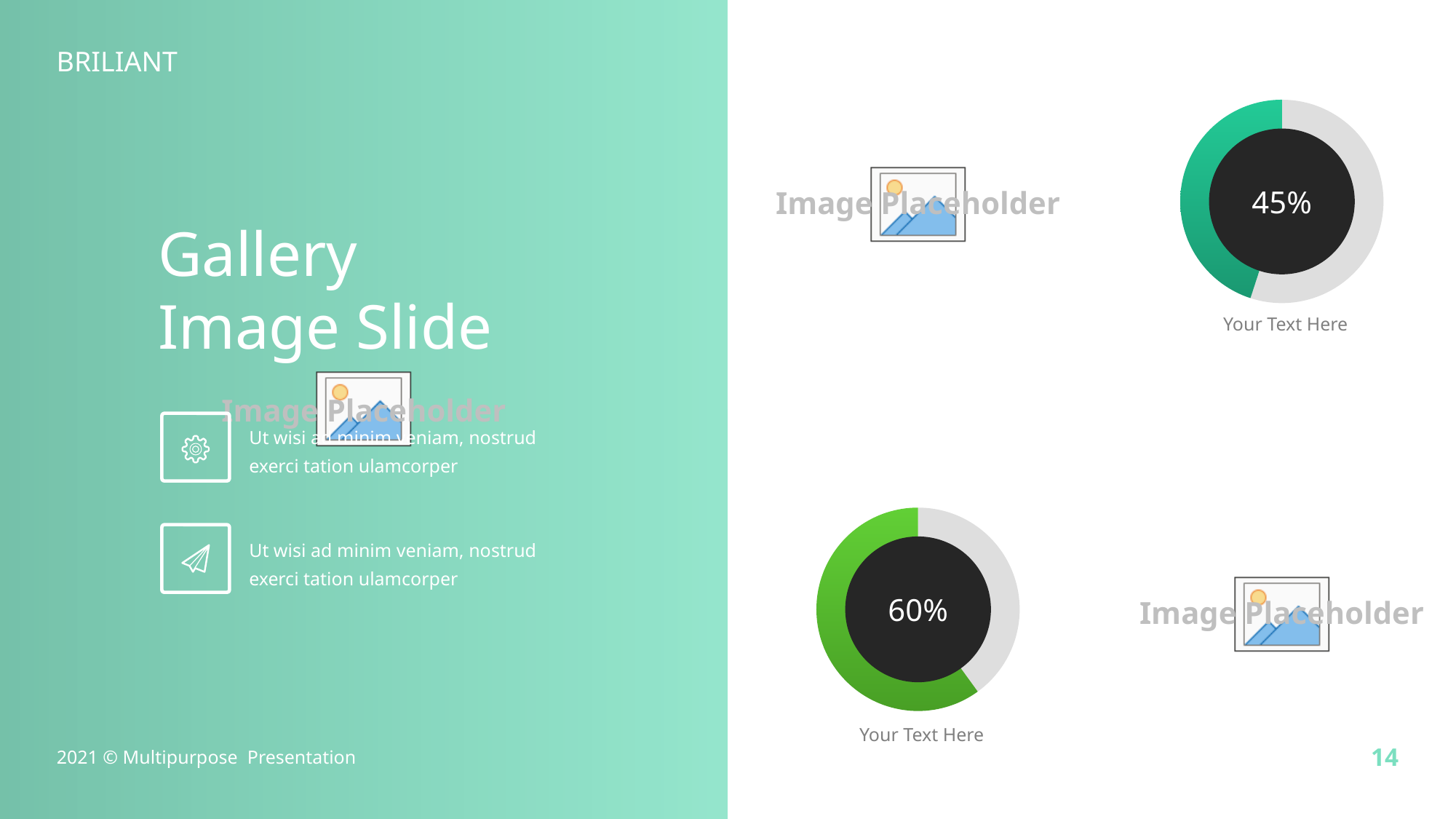
What caption appears below the top-right donut chart? Your Text Here What kind of chart is used to display the 45% and 60% values on the slide? Donut chart What percentage is shown in the centre of the top-right donut chart? 45% What share of the top-right donut chart is left unfilled (grey)? 55% Which donut chart has the highest value on the slide? The bottom donut chart (60%) What is the difference between the value in the bottom donut chart and the value in the top-right donut chart? 15 percentage points Is the value shown in the top-right donut chart greater or less than 50%? less How many donut charts are on the slide? 2 What colour is the filled portion of the bottom donut chart? Green Which donut chart shows the larger value, the top-right one or the bottom one? The bottom one (60%) What percentage is shown in the centre of the bottom donut chart? 60% Is the value shown in the bottom donut chart greater or less than 50%? greater